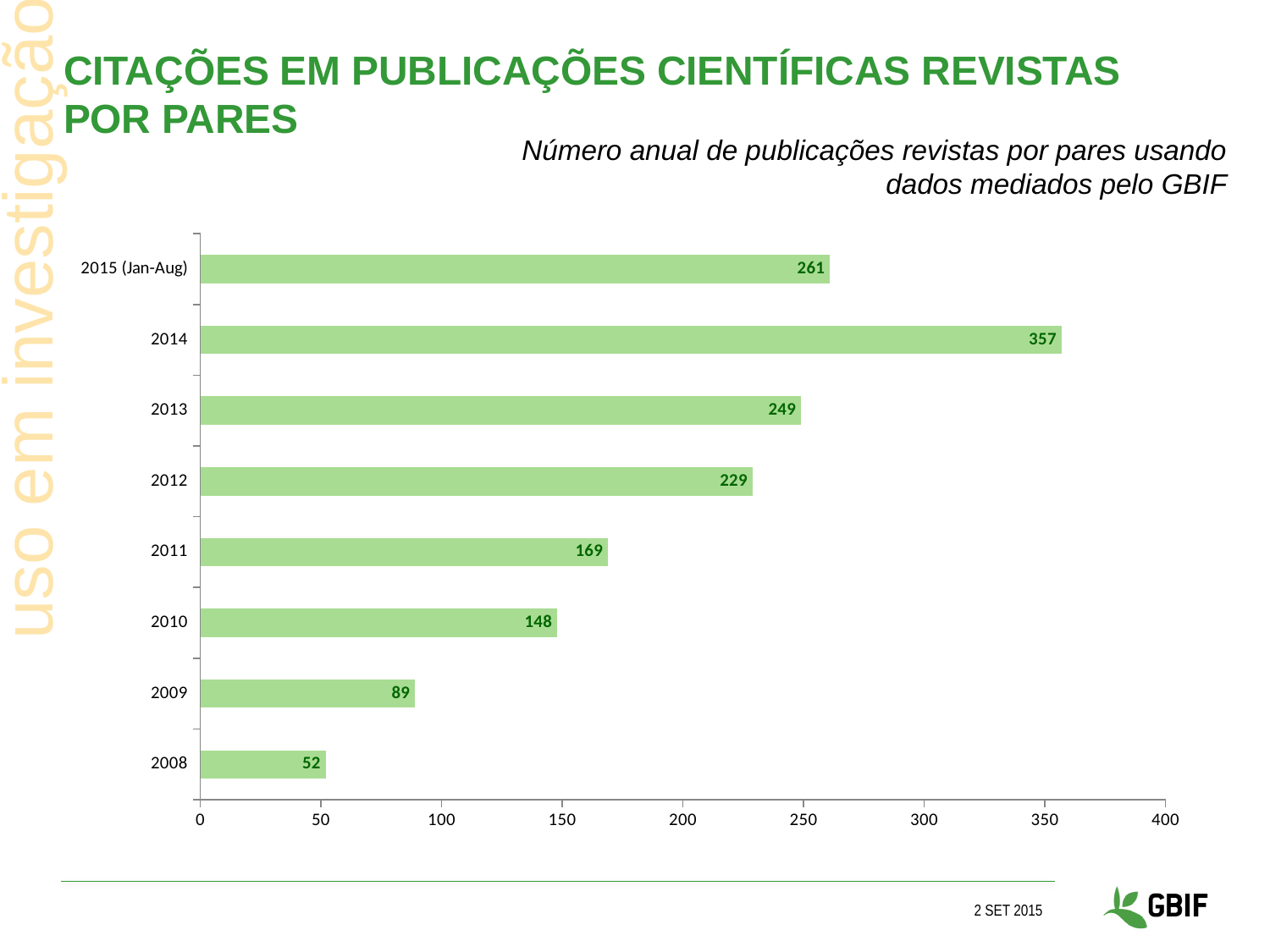
What is the value for 2015 (Jan-Aug)? 261 Which year has the highest value? 2014 Is the value for 2013 greater or less than 200? greater What is the value for 2014? 357 Which is larger, the value for 2012 or the value for 2011? 2012 What is the maximum value shown on the horizontal axis? 400 What is the value for 2008? 52 How many categories (years) are shown in the chart? 8 What kind of chart is shown on the slide? bar chart What is the difference between the values for 2010 and 2009? 59 Which year has the lowest value? 2008 What is the difference between the values for 2014 and 2013? 108